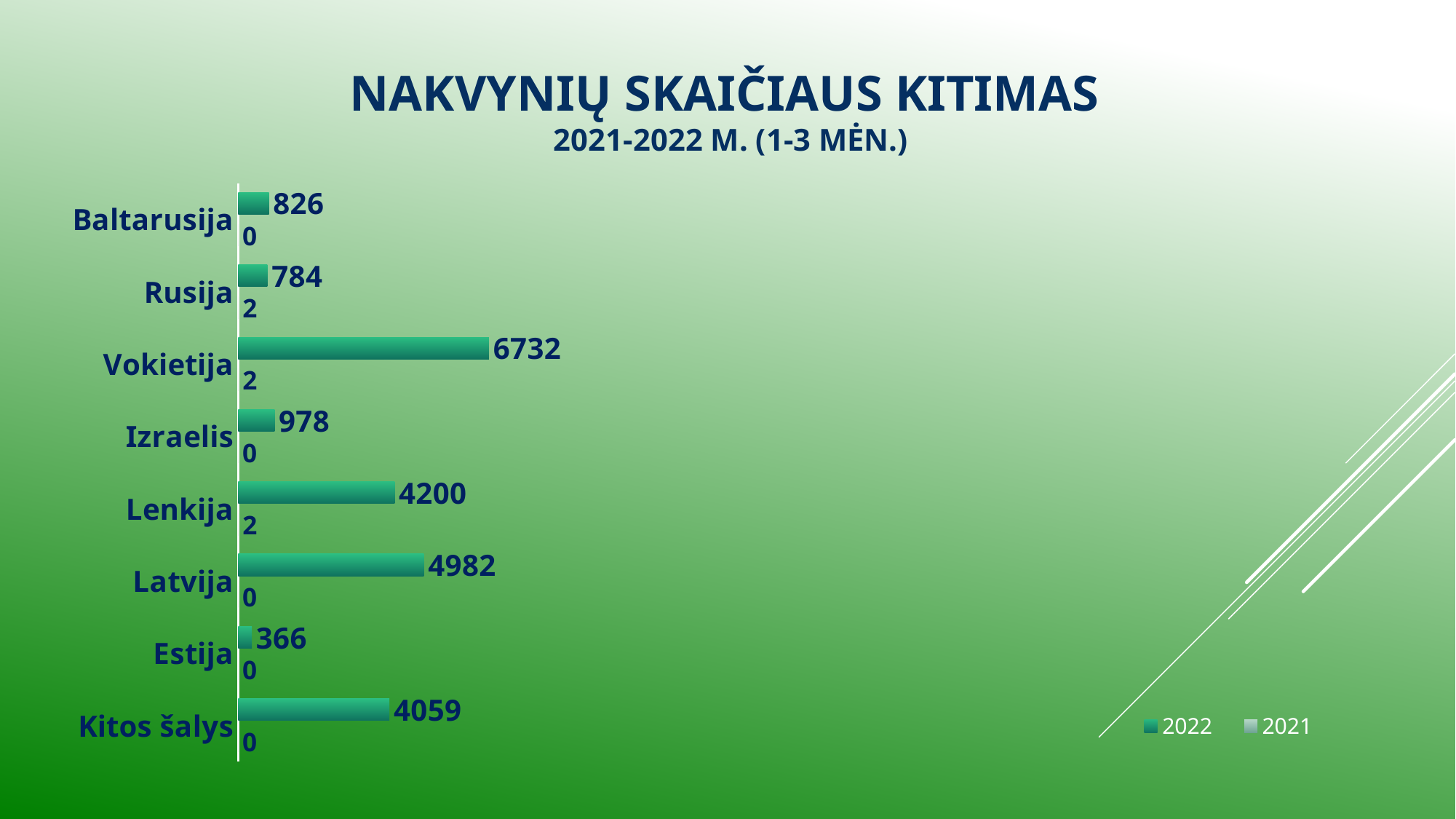
Which category has the highest 2022 value? Vokietija What is the 2021 value for Rusija? 2 What is the difference between the 2022 values for Latvija and Lenkija? 782 How many categories are shown on the chart? 8 Which category has the lowest 2022 value? Estija What is the title of the chart? NAKVYNIŲ SKAIČIAUS KITIMAS 2021-2022 M. (1-3 MĖN.) What is the 2022 value for Vokietija? 6732 What is the 2022 value for Latvija? 4982 How many series does the legend list? 2 What is the 2022 value for Estija? 366 What kind of chart is shown on the slide? Bar chart Which has a larger 2022 value, Izraelis or Baltarusija? Izraelis